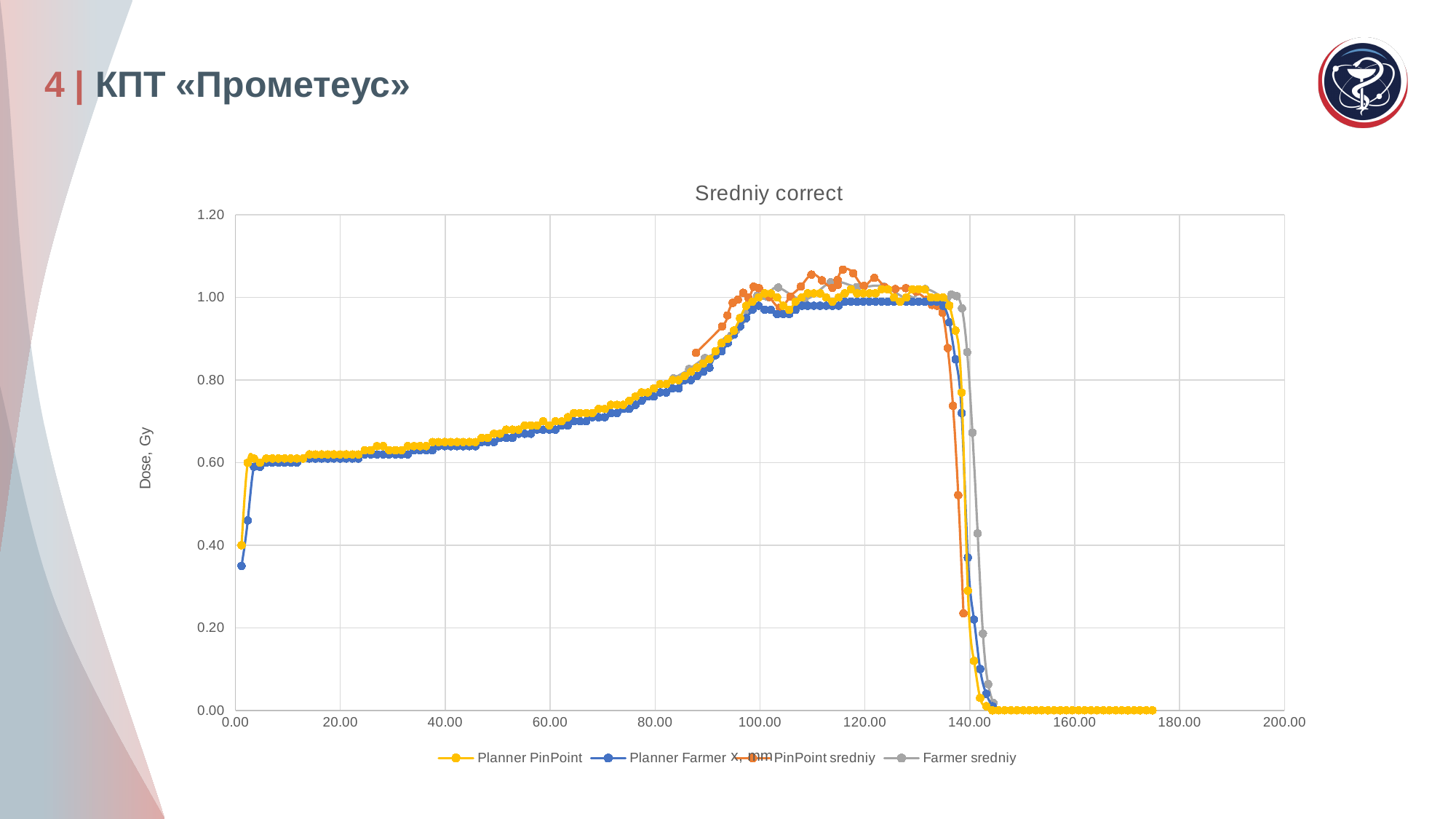
What is the label of the vertical axis of the chart? Dose, Gy Which series reaches the highest peak value on the chart? PinPoint sredniy At x = 0.00, which is larger: the value of Planner PinPoint or the value of Planner Farmer? Planner PinPoint How many series does the legend of the chart list? 4 Do the values of Farmer sredniy rise or fall as x increases from 136 to 145? fall What kind of chart is shown on the slide? line chart Is the value of Planner PinPoint at x = 60.00 greater or less than 0.60? greater Do the values of Planner PinPoint rise or fall as x increases from 20.00 to 100.00? rise Is the value of Planner Farmer at x = 0.00 greater or less than 0.40? less What is the title of the chart? Sredniy correct Is the value of Planner Farmer at x = 40.00 greater or less than 0.60? greater